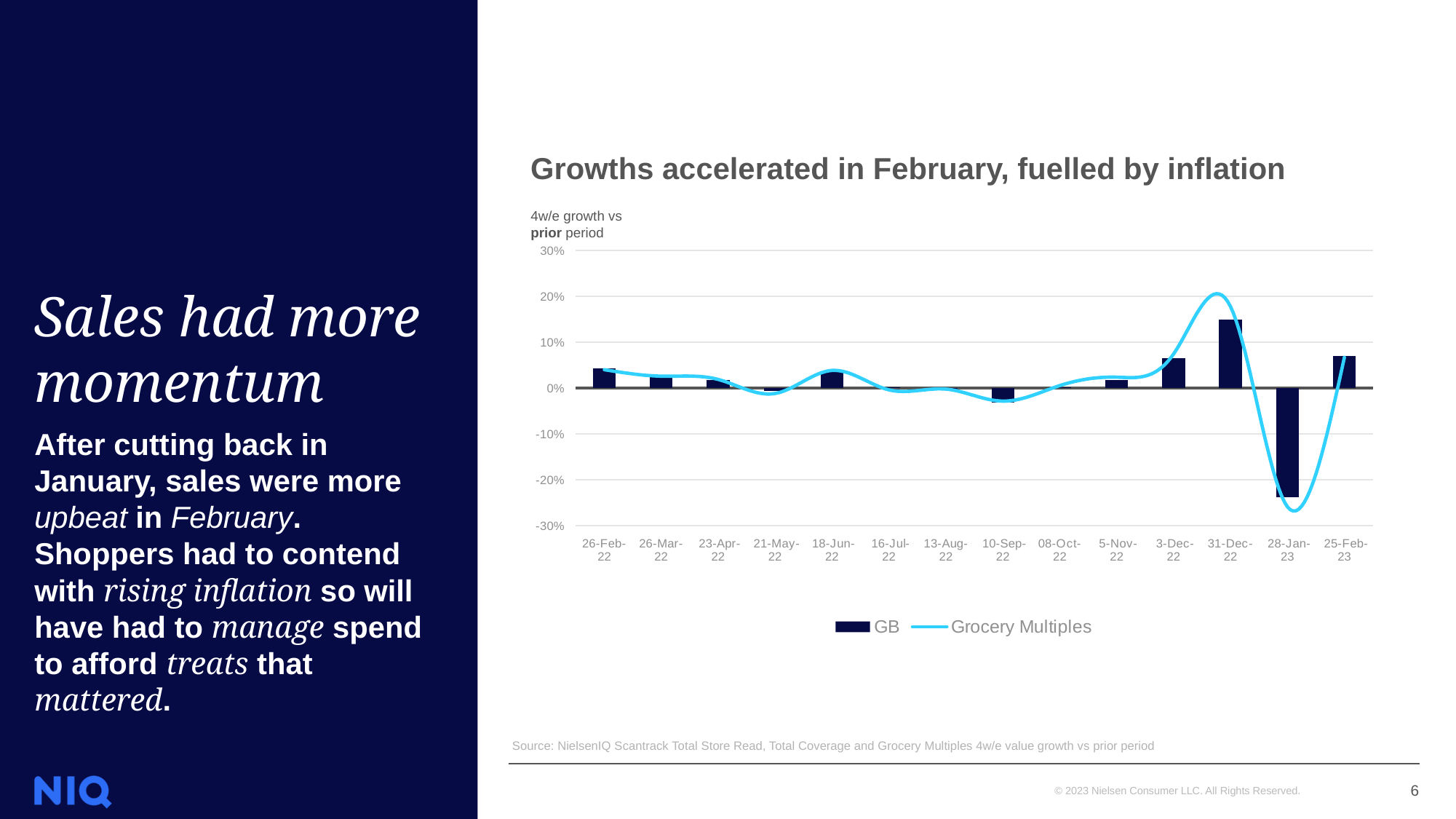
How many series does the chart legend list? 2 Is the GB value for 31-Dec-22 greater or less than 10%? greater Do the GB values rise or fall from 31-Dec-22 to 28-Jan-23? fall Is the GB value for 28-Jan-23 greater or less than -20%? less What kind of chart is shown on the slide? A combined bar and line chart Is the Grocery Multiples value for 28-Jan-23 greater or less than -20%? less How many time periods are shown on the x axis of the chart? 14 In which period is the GB bar highest? 31-Dec-22 What is the title of the chart? Growths accelerated in February, fuelled by inflation Which has the larger GB value, 31-Dec-22 or 3-Dec-22? 31-Dec-22 In which period is the GB bar lowest? 28-Jan-23 Which series are listed in the chart legend? GB and Grocery Multiples